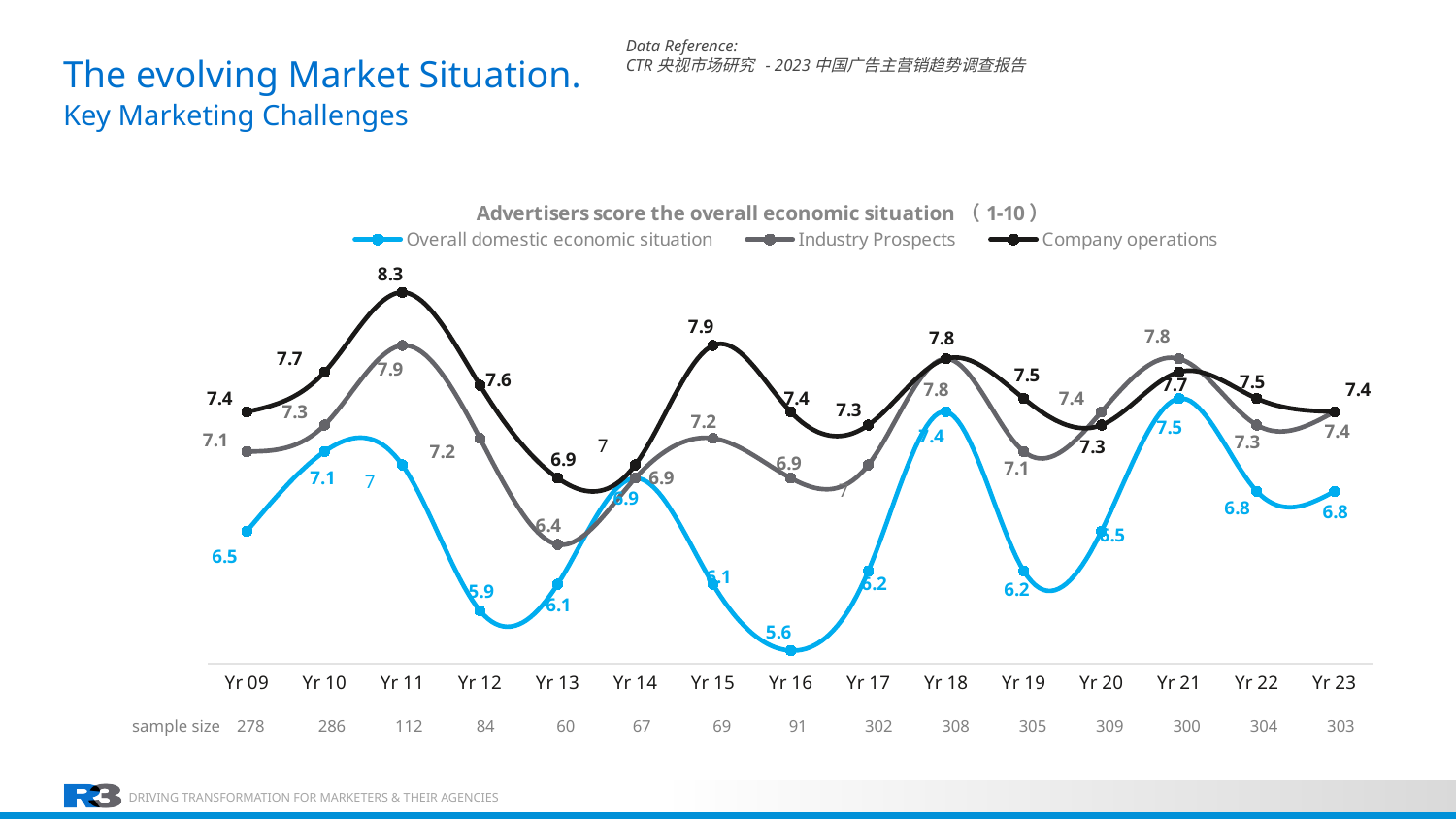
What is the sample size shown for Yr 09? 278 What is the Company operations score in Yr 11? 8.3 How many years are plotted along the x axis? 15 Does the Overall domestic economic situation score rise or fall from Yr 21 to Yr 22? fall What is the Overall domestic economic situation score in Yr 16? 5.6 What kind of chart is shown on the slide? line chart In Yr 11, how much higher is the Company operations score than the Overall domestic economic situation score? 1.3 In Yr 13, which is higher: Industry Prospects or Company operations? Company operations In which year is the Overall domestic economic situation score lowest? Yr 16 What is the Industry Prospects score in Yr 13? 6.4 In which year does the Company operations series reach its highest score? Yr 11 How many series does the legend list? 3